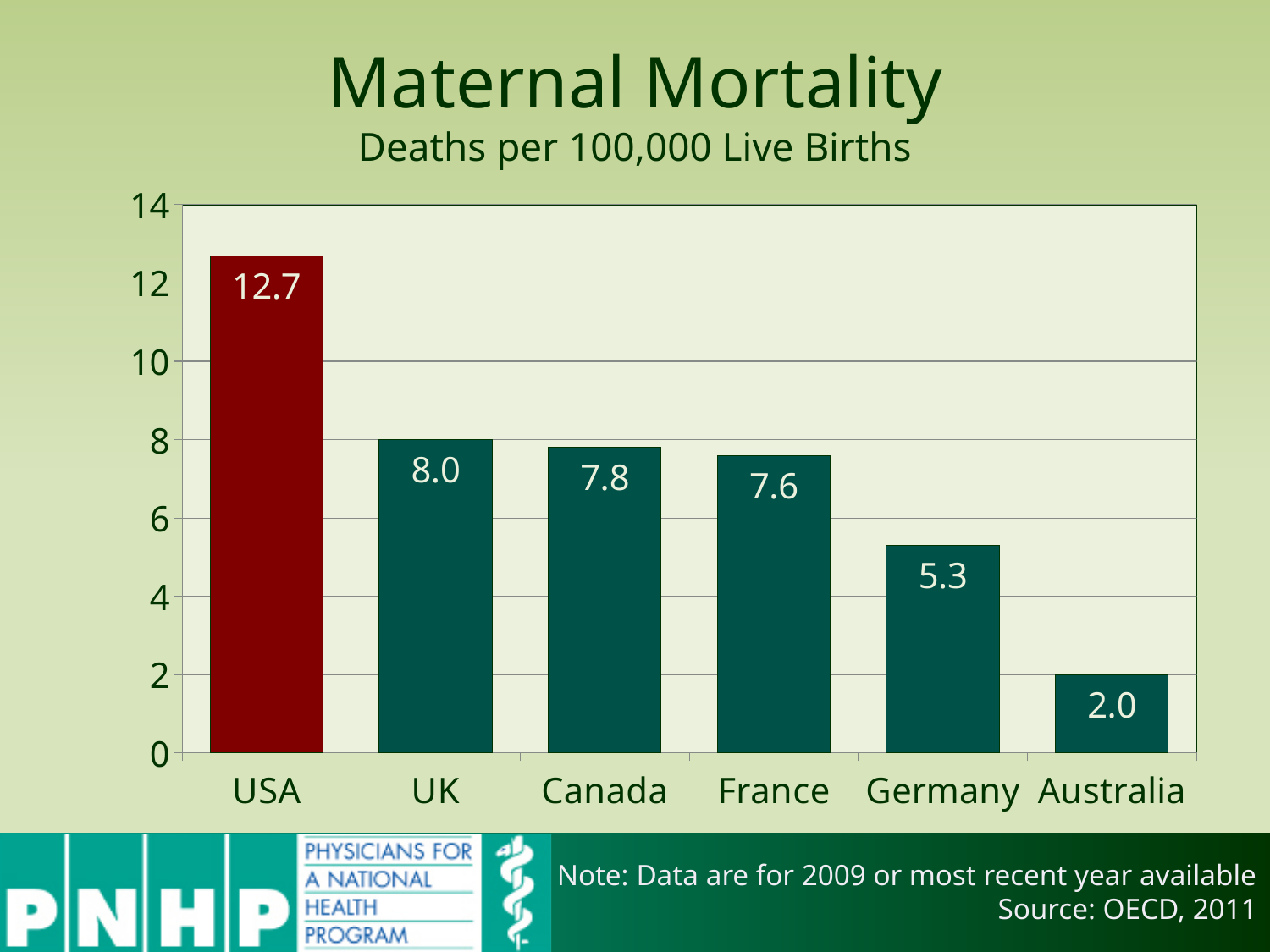
What is the maternal mortality value for Australia? 2.0 What is the maternal mortality value for the USA? 12.7 Is the value for France greater or less than 10? less Which country has the lowest maternal mortality on the chart? Australia Which country's bar is coloured red rather than green? USA What is the maternal mortality value for Germany? 5.3 Which has a higher maternal mortality value, Canada or Germany? Canada How many countries are shown on the chart? 6 What is the difference between the Germany and Australia values? 3.3 Which country has the highest maternal mortality on the chart? USA What kind of chart is shown on the slide? bar chart What is the difference between the USA and UK values? 4.7